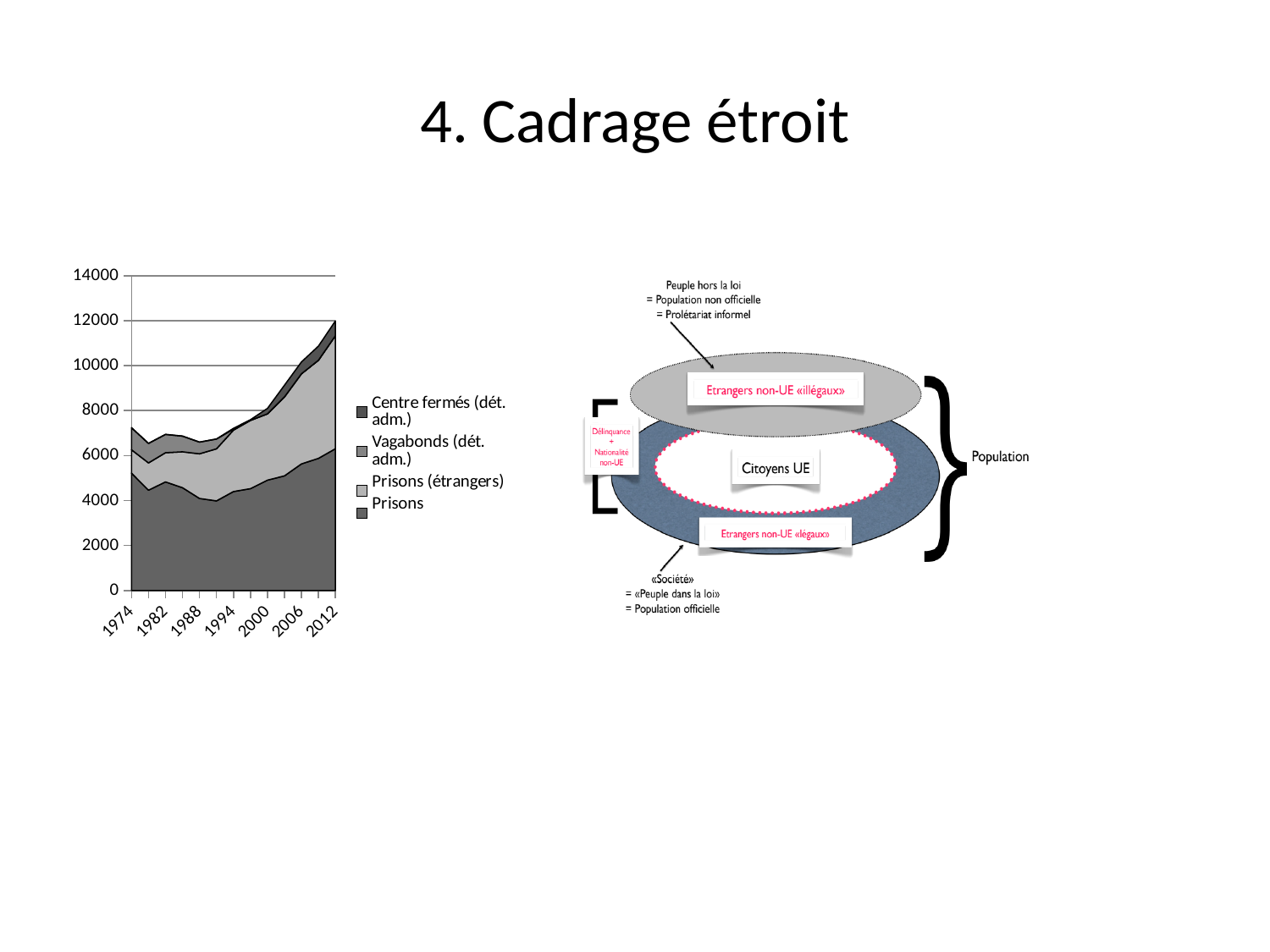
What is the highest value shown on the y axis of the left chart? 14000 In the left chart, is the total stacked value in 1974 greater or less than 6000? greater In the left chart, is the total stacked value in 2012 greater or less than 10000? greater In the left chart, does the total stacked value rise or fall between 2000 and 2012? rise Which series forms the bottom (darkest) layer of the left chart? Prisons How many year labels are shown on the x axis of the left chart? 7 What kind of chart is shown on the left of the slide? Stacked area chart In the left chart, is the value for Prisons in 1974 greater or less than 6000? less Which series is listed first in the legend of the left chart? Centre fermés (dét. adm.) How many series does the legend of the left chart list? 4